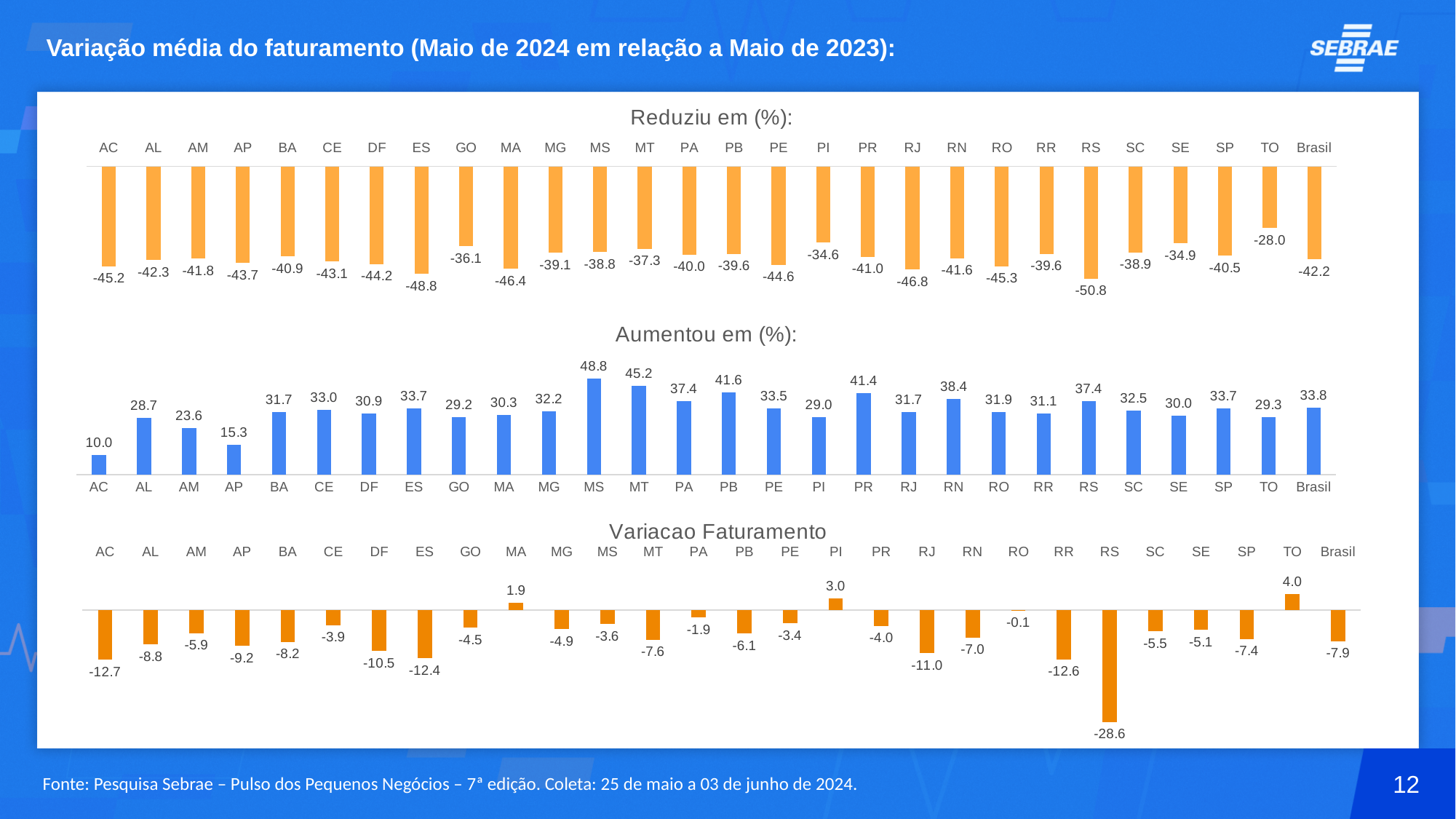
In the "Aumentou em (%):" chart, what is the value for Brasil? 33.8 In the "Aumentou em (%):" chart, which category has the highest value? MS In the "Aumentou em (%):" chart, what is the difference between the values for MS and AC? 38.8 What colour are the bars in the "Aumentou em (%):" chart? Blue How many categories are shown in the "Variacao Faturamento" chart? 28 In the "Variacao Faturamento" chart, which is larger, the value for MA or the value for PI? PI In the "Reduziu em (%):" chart, what is the value for RS? -50.8 In the "Variacao Faturamento" chart, which category has the highest value? TO In the "Aumentou em (%):" chart, which category has the lowest value? AC What kind of chart is the "Aumentou em (%):" chart? Bar chart In the "Variacao Faturamento" chart, what is the value for RS? -28.6 In the "Reduziu em (%):" chart, which category has the smallest magnitude (the shortest bar)? TO